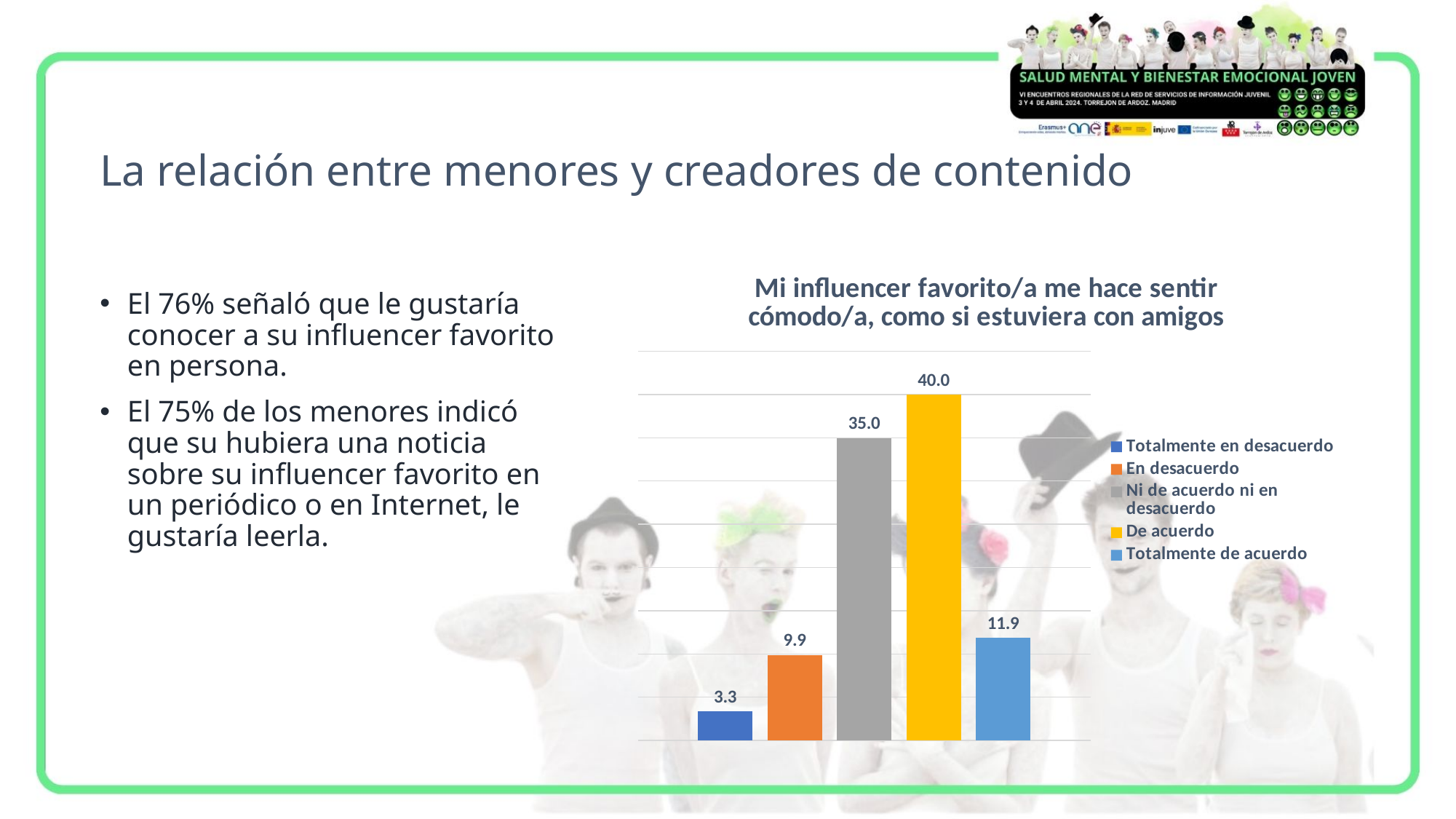
Which category has the highest value? De acuerdo What is the value for "Totalmente en desacuerdo"? 3.3 What kind of chart is shown on the slide? Bar chart Which is larger, the value for "En desacuerdo" or the value for "Totalmente de acuerdo"? Totalmente de acuerdo How many bars are plotted in the chart? 5 Which category has the lowest value? Totalmente en desacuerdo What is the value for "De acuerdo"? 40.0 What is the difference between the values for "De acuerdo" and "Ni de acuerdo ni en desacuerdo"? 5.0 What is the value for "Totalmente de acuerdo"? 11.9 How many entries does the legend list? 5 What is the title of the chart? Mi influencer favorito/a me hace sentir cómodo/a, como si estuviera con amigos What is the value for "Ni de acuerdo ni en desacuerdo"? 35.0